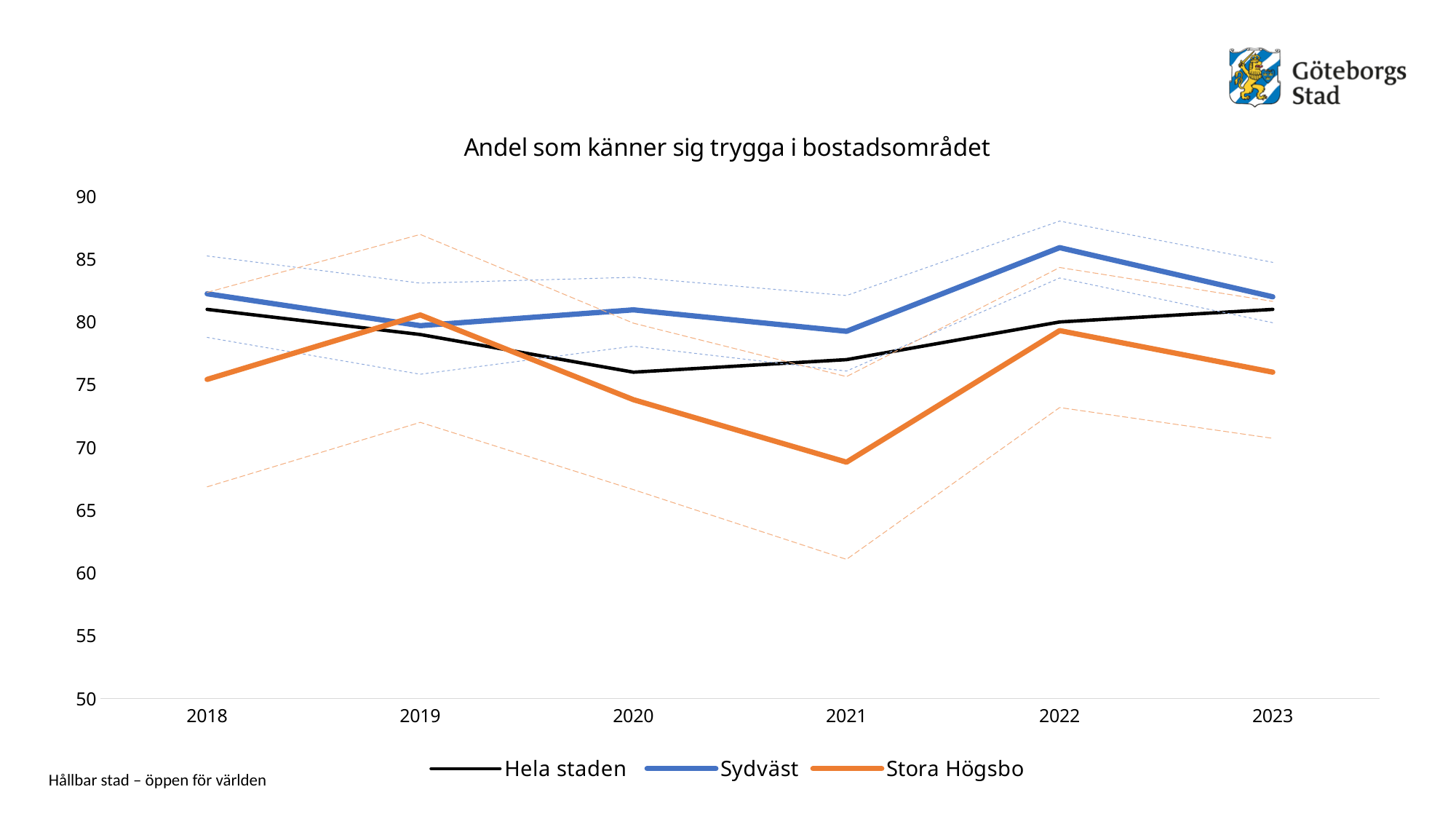
In 2021, which is larger: the value for Sydväst or the value for Stora Högsbo? Sydväst In which year is the value for Sydväst highest? 2022 How many series does the legend list? 3 How many years are shown on the x axis? 6 What kind of chart is shown on the slide? line chart Is the value for Hela staden in 2023 greater or less than 80? greater Is the value for Sydväst in 2022 greater or less than 85? greater Which series is drawn in orange? Stora Högsbo Does the value for Stora Högsbo rise or fall from 2019 to 2021? fall Is the value for Stora Högsbo in 2021 greater or less than 70? less In which year is the value for Stora Högsbo lowest? 2021 What is the title of the chart? Andel som känner sig trygga i bostadsområdet